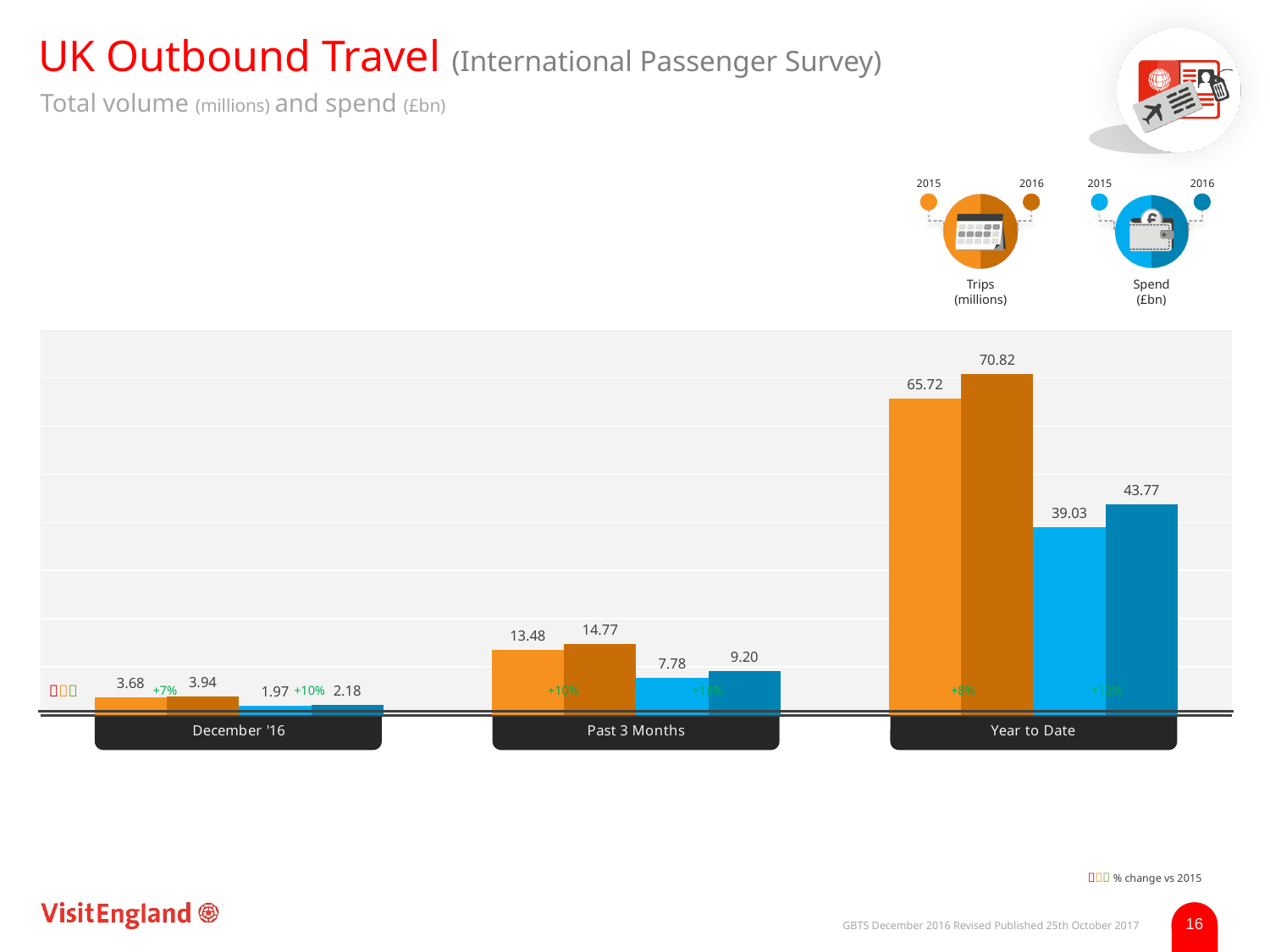
How many time periods are shown on the x axis of the chart? 3 What is the value for Spend (£bn) in 2016 for December '16? 2.18 What is the percentage change vs 2015 shown for Trips in the Year to Date period? +8% What is the value for Spend (£bn) in 2015 for Past 3 Months? 7.78 Which period has the lowest value for Spend (£bn) in 2015? December '16 Which period has the highest value for Trips (millions) in 2016? Year to Date What is the value for Trips (millions) in 2016 for Year to Date? 70.82 What is the difference between Spend (£bn) in 2016 and 2015 for Past 3 Months? 1.42 What is the difference between Trips (millions) in 2016 and 2015 for Year to Date? 5.10 What kind of chart is shown on the slide? Bar chart Which is larger for Year to Date: Spend (£bn) in 2015 or Spend (£bn) in 2016? Spend (£bn) in 2016 What is the value for Trips (millions) in 2015 for December '16? 3.68